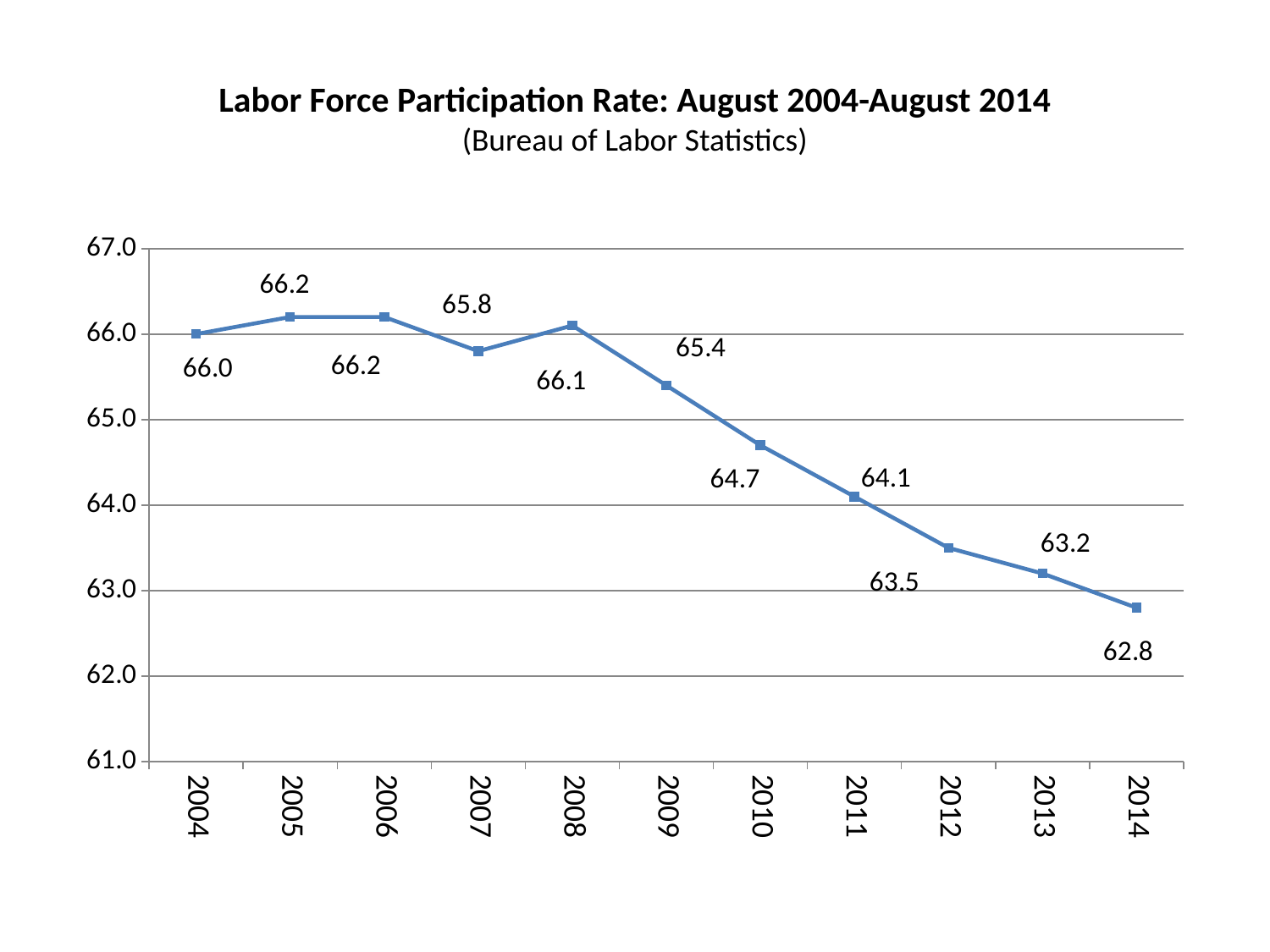
Which year has the lowest labor force participation rate? 2014 How many years are plotted on the chart? 11 What is the labor force participation rate for 2011? 64.1 What kind of chart is shown on the slide? line chart What is the difference between the labor force participation rate in 2004 and in 2014? 3.2 Which year has a higher labor force participation rate, 2007 or 2012? 2007 Does the labor force participation rate generally rise or fall from 2008 to 2014? fall What source is cited in the chart's subtitle? Bureau of Labor Statistics What is the labor force participation rate for 2008? 66.1 What is the labor force participation rate for 2014? 62.8 Is the value for 2010 greater or less than 65.0? less What is the difference between the labor force participation rate in 2009 and in 2010? 0.7